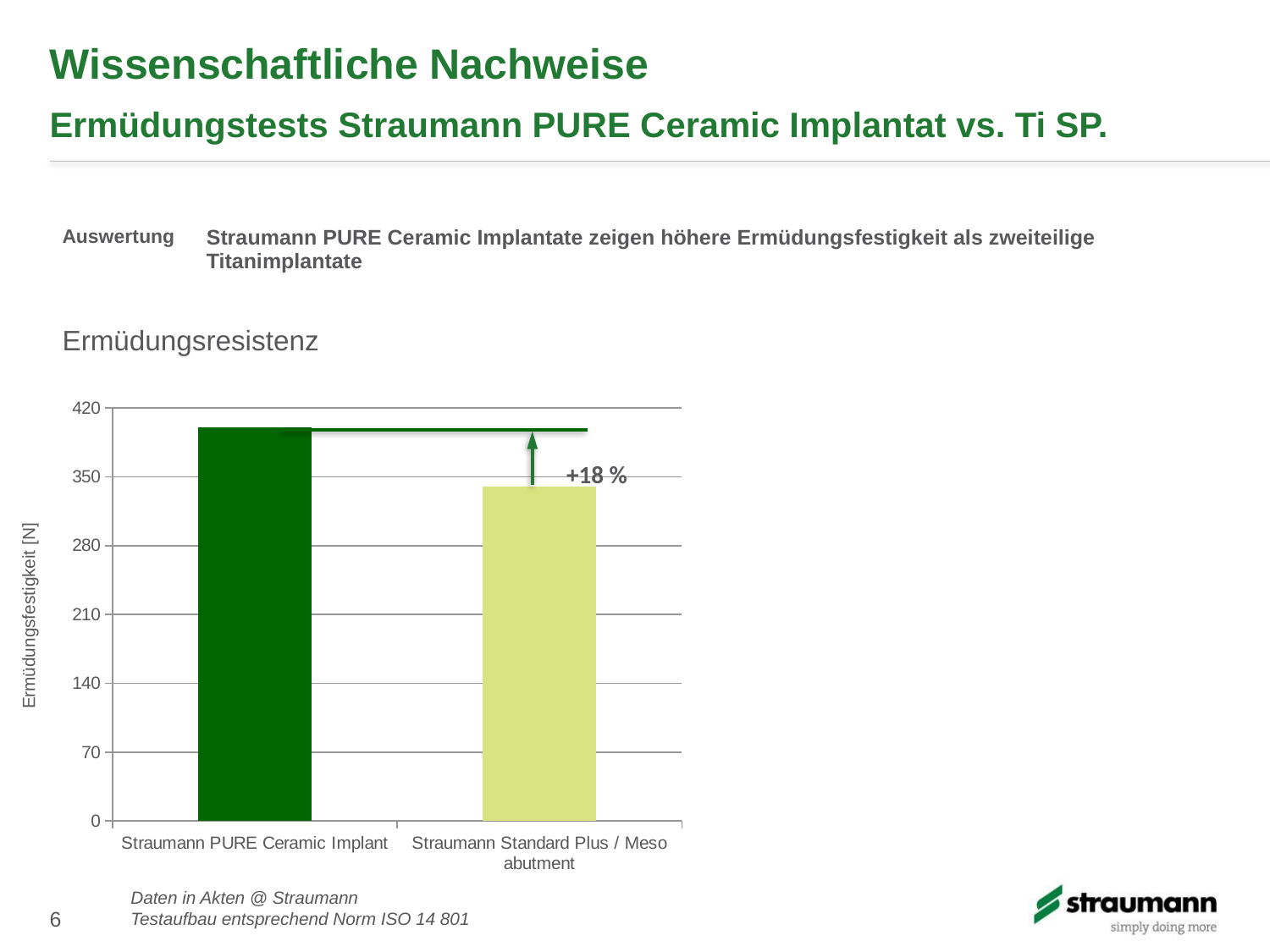
What kind of chart is shown on the slide? bar chart Is the value for Straumann Standard Plus / Meso abutment greater or less than 280? greater Which is larger: the value for Straumann PURE Ceramic Implant or for Straumann Standard Plus / Meso abutment? Straumann PURE Ceramic Implant Which category has the lowest value in the chart? Straumann Standard Plus / Meso abutment Is the value for Straumann PURE Ceramic Implant greater or less than 350? greater What is the label of the y axis of the chart? Ermüdungsfestigkeit [N] What percentage difference is annotated between the two bars in the chart? +18 % Is the value for Straumann PURE Ceramic Implant greater or less than 420? less Which category has the highest fatigue strength (Ermüdungsfestigkeit) in the chart? Straumann PURE Ceramic Implant How many bars are plotted in the chart? 2